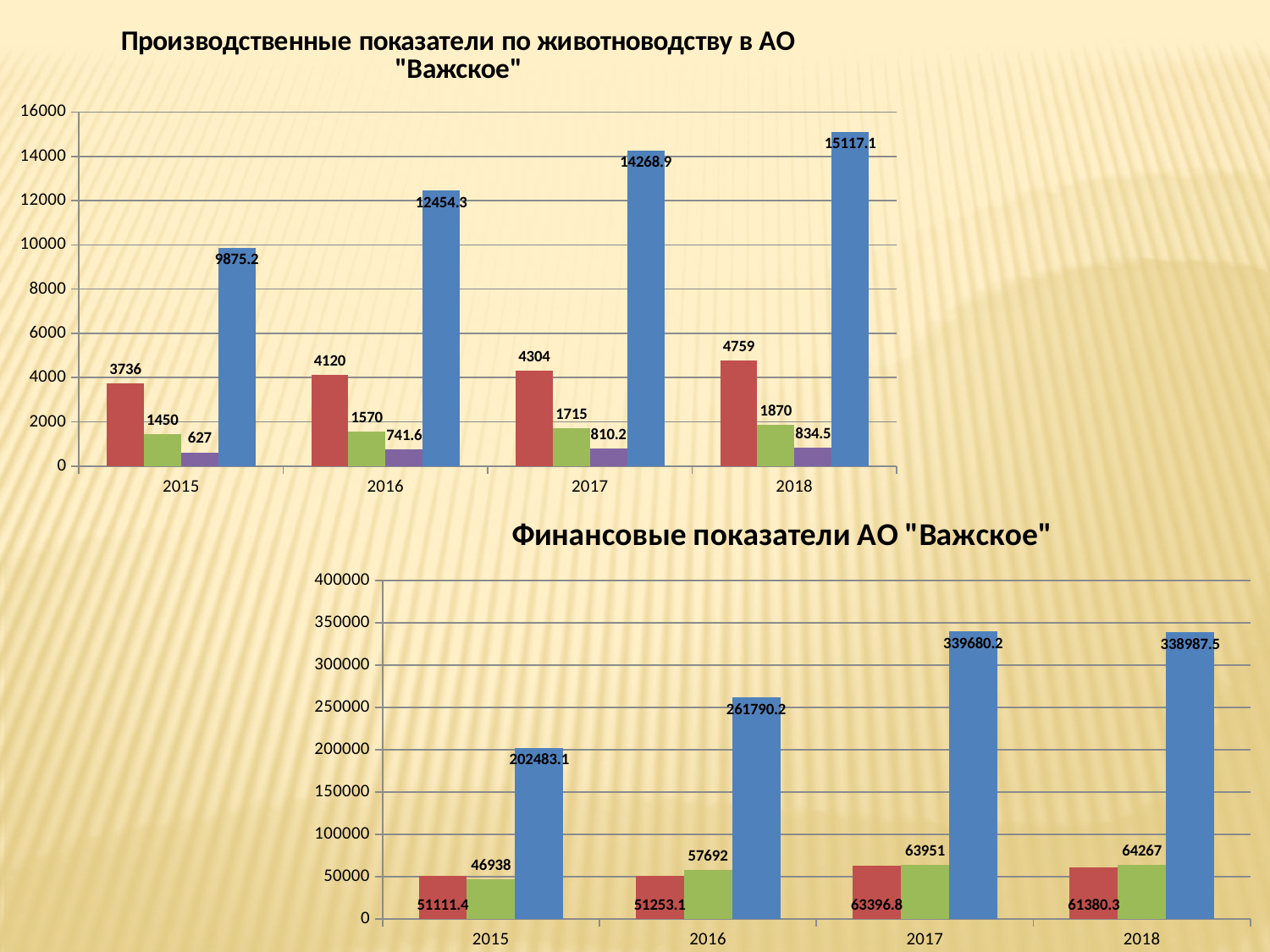
In the bottom chart "Финансовые показатели АО "Важское"", what is the value of the blue bar for 2017? 339680.2 In the top chart "Производственные показатели по животноводству в АО "Важское"", what is the difference between the blue bar values for 2016 and 2015? 2579.1 How many years are shown on the x axis of the top chart "Производственные показатели по животноводству в АО "Важское""? 4 In the top chart "Производственные показатели по животноводству в АО "Важское"", what is the value of the red bar for 2016? 4120 In the top chart "Производственные показатели по животноводству в АО "Важское"", do the blue bar values rise or fall from 2015 to 2018? rise In the bottom chart "Финансовые показатели АО "Важское"", which is larger: the red bar for 2017 or the green bar for 2017? the green bar (63951) In the top chart "Производственные показатели по животноводству в АО "Важское"", in which year is the green bar lowest? 2015 What kind of chart is the bottom chart "Финансовые показатели АО "Важское""? bar chart In the top chart "Производственные показатели по животноводству в АО "Важское"", what is the value of the blue bar for 2018? 15117.1 In the top chart "Производственные показатели по животноводству в АО "Важское"", in which year is the blue bar highest? 2018 In the top chart "Производственные показатели по животноводству в АО "Важское"", what is the value of the purple bar for 2017? 810.2 In the bottom chart "Финансовые показатели АО "Важское"", what is the value of the green bar for 2016? 57692